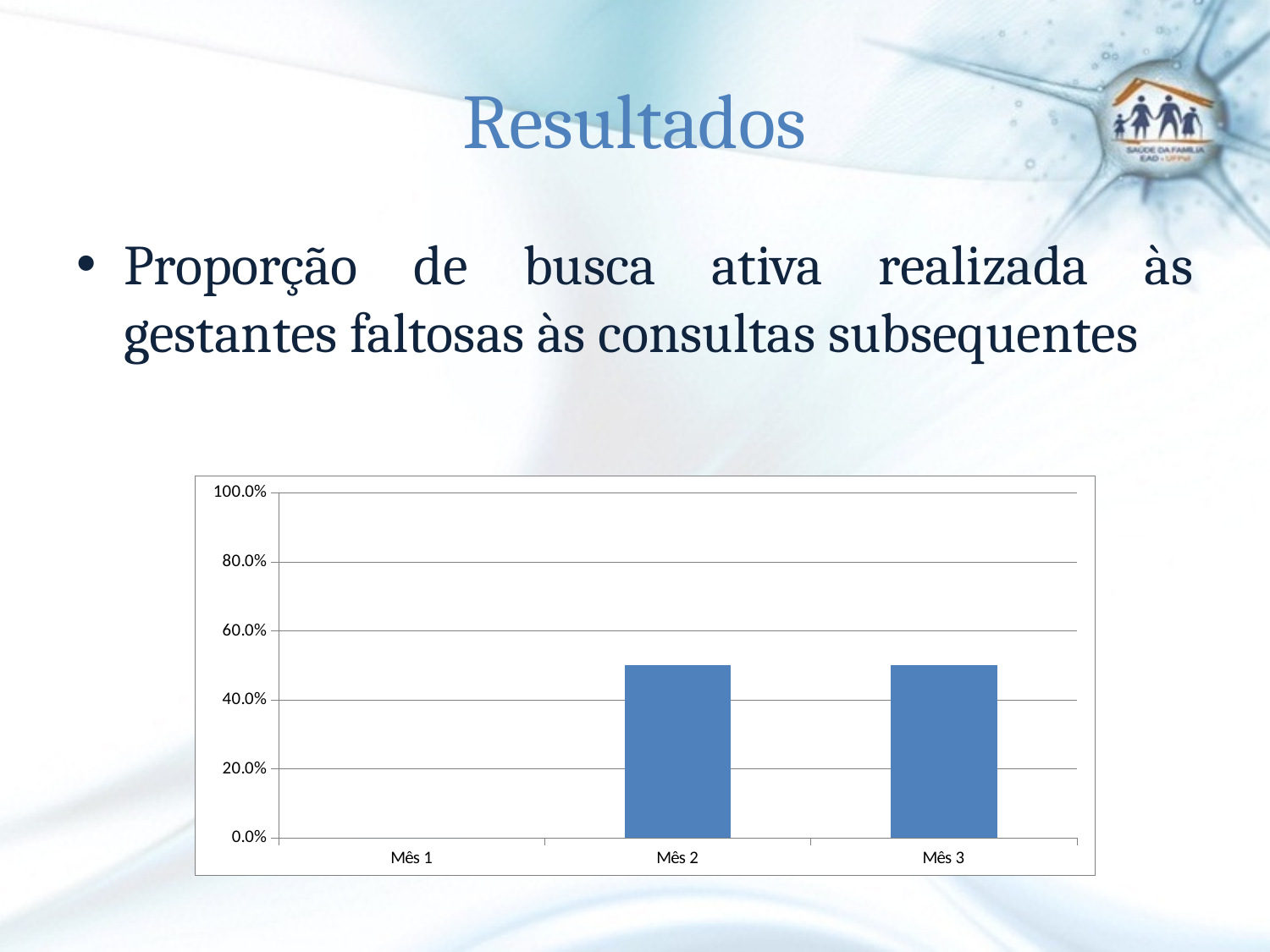
Is the value for Mês 2 greater or less than 40.0%? greater Is the value for Mês 3 greater or less than 40.0%? greater Which is larger, the value for Mês 3 or the value for Mês 1? Mês 3 What is the value for Mês 1 in the chart? 0.0% Which is larger, the value for Mês 1 or the value for Mês 2? Mês 2 Does the value rise or fall from Mês 1 to Mês 2? rise How many categories are shown on the x axis of the chart? 3 What is the highest value labelled on the y axis of the chart? 100.0% Is the value for Mês 3 greater or less than 60.0%? less Which category has the lowest value in the chart? Mês 1 What kind of chart is shown on the slide? bar chart